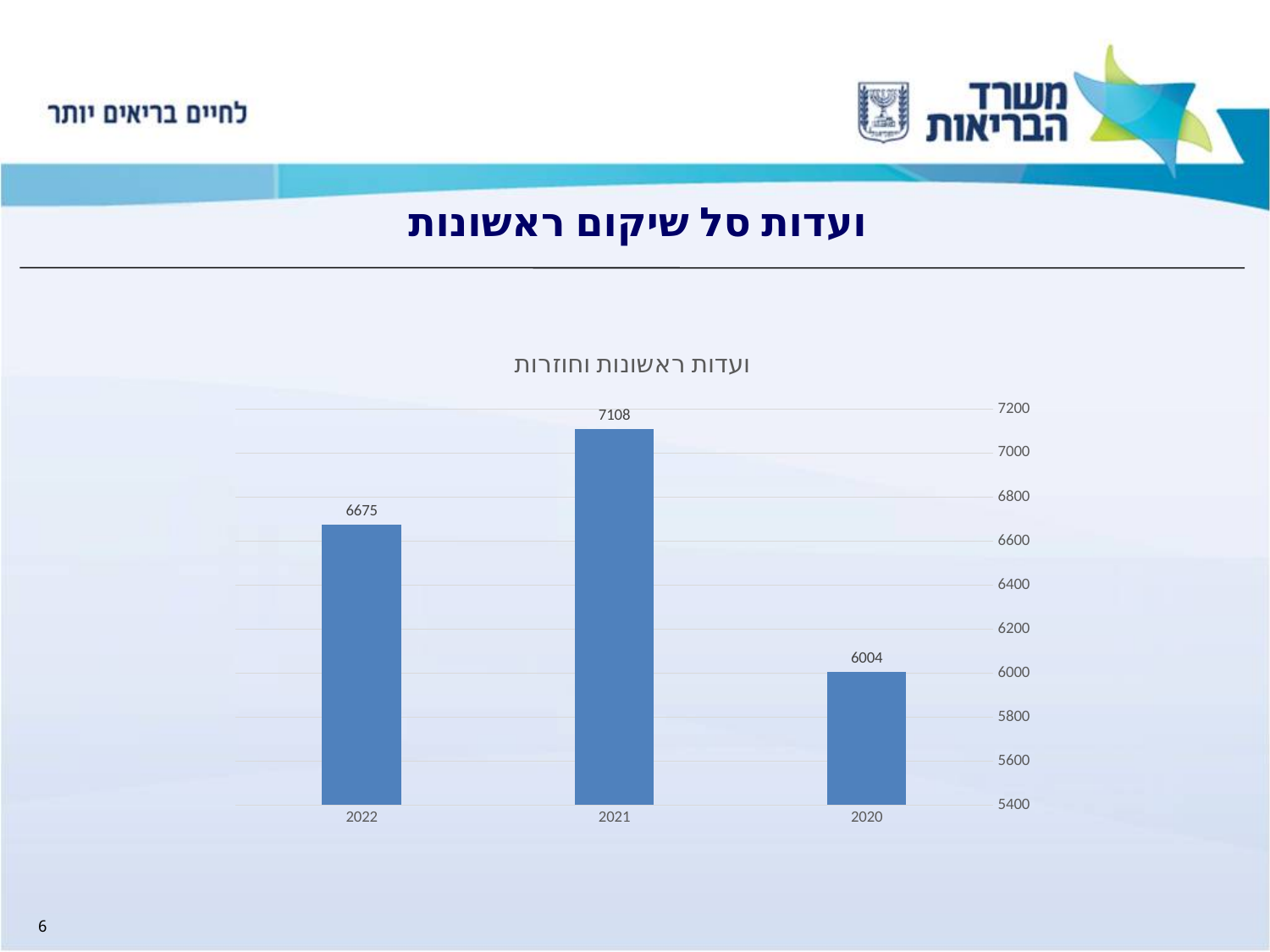
Which is larger, the value for 2022 or the value for 2020? 2022 How many years are shown on the chart? 3 What is the value for 2020? 6004 What is the title of the chart? ועדות ראשונות וחוזרות What is the value for 2022? 6675 What kind of chart is shown on the slide? bar chart Is the value for 2021 greater or less than 7000? greater Which year has the lowest value? 2020 What is the value for 2021? 7108 What is the difference between the values for 2021 and 2022? 433 Which year has the highest value? 2021 What is the difference between the values for 2022 and 2020? 671